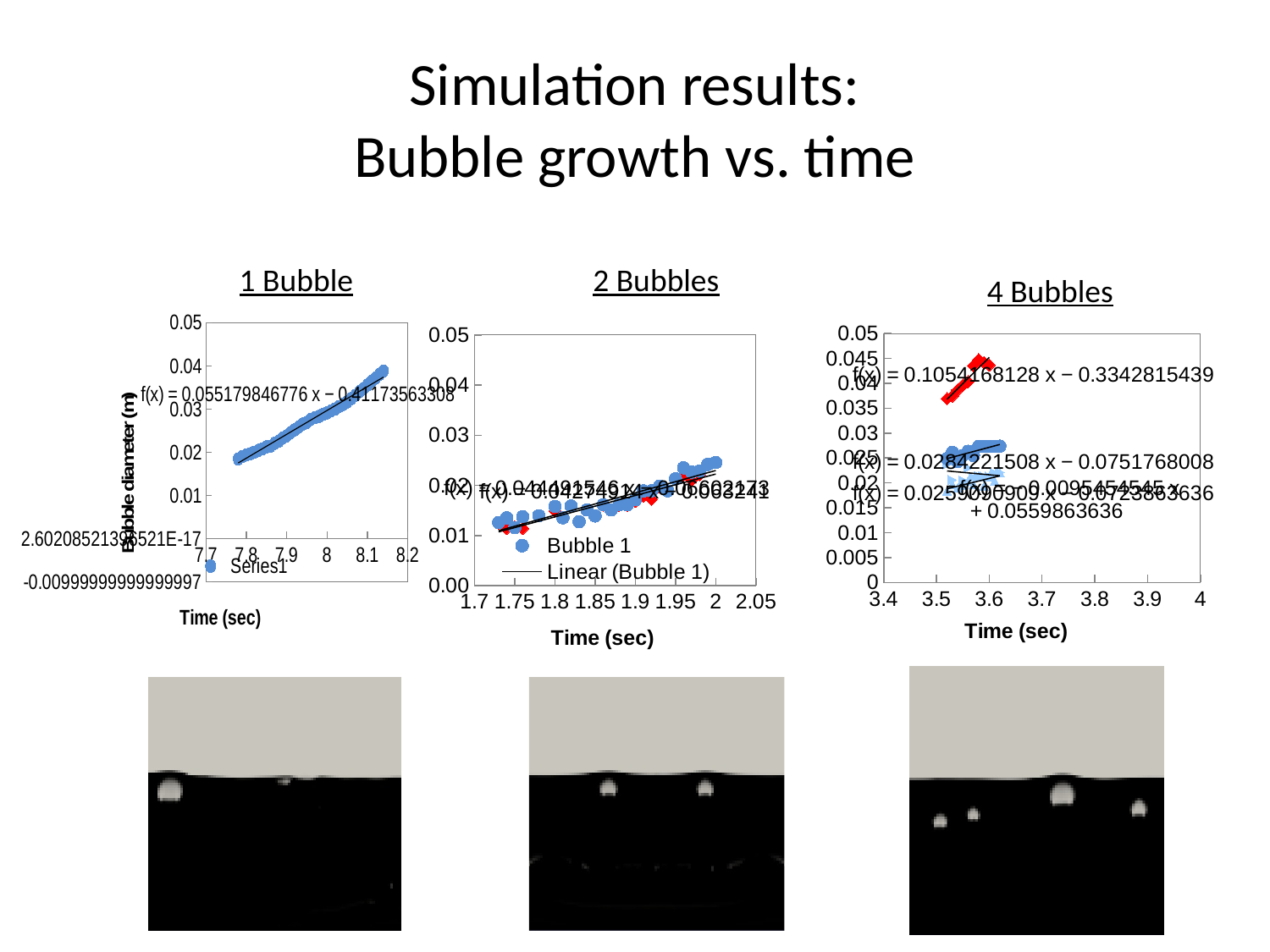
On the '4 Bubbles' chart, what is the slope (coefficient of x) in the topmost trendline equation? 0.1054168128 On the '1 Bubble' chart, what is the name of the series shown in the legend? Series1 On the '4 Bubbles' chart, what is the largest value shown on the x axis? 4 On the '2 Bubbles' chart, are the plotted values near time 1.75 greater or less than 0.02? less On the '1 Bubble' chart, are the plotted values at time 8.1 greater or less than 0.03? greater What kind of chart is the '1 Bubble' chart? scatter chart On the '1 Bubble' chart, do the bubble diameter values rise or fall as time increases? rise On the '1 Bubble' chart, what is the x-axis title? Time (sec) On the '4 Bubbles' chart, are the red diamond points greater or less than 0.03? greater On the '2 Bubbles' chart, do the plotted values rise or fall as time increases? rise How many entries does the legend of the '2 Bubbles' chart list? 2 On the '1 Bubble' chart, what is the slope (coefficient of x) in the displayed trendline equation? 0.055179846776